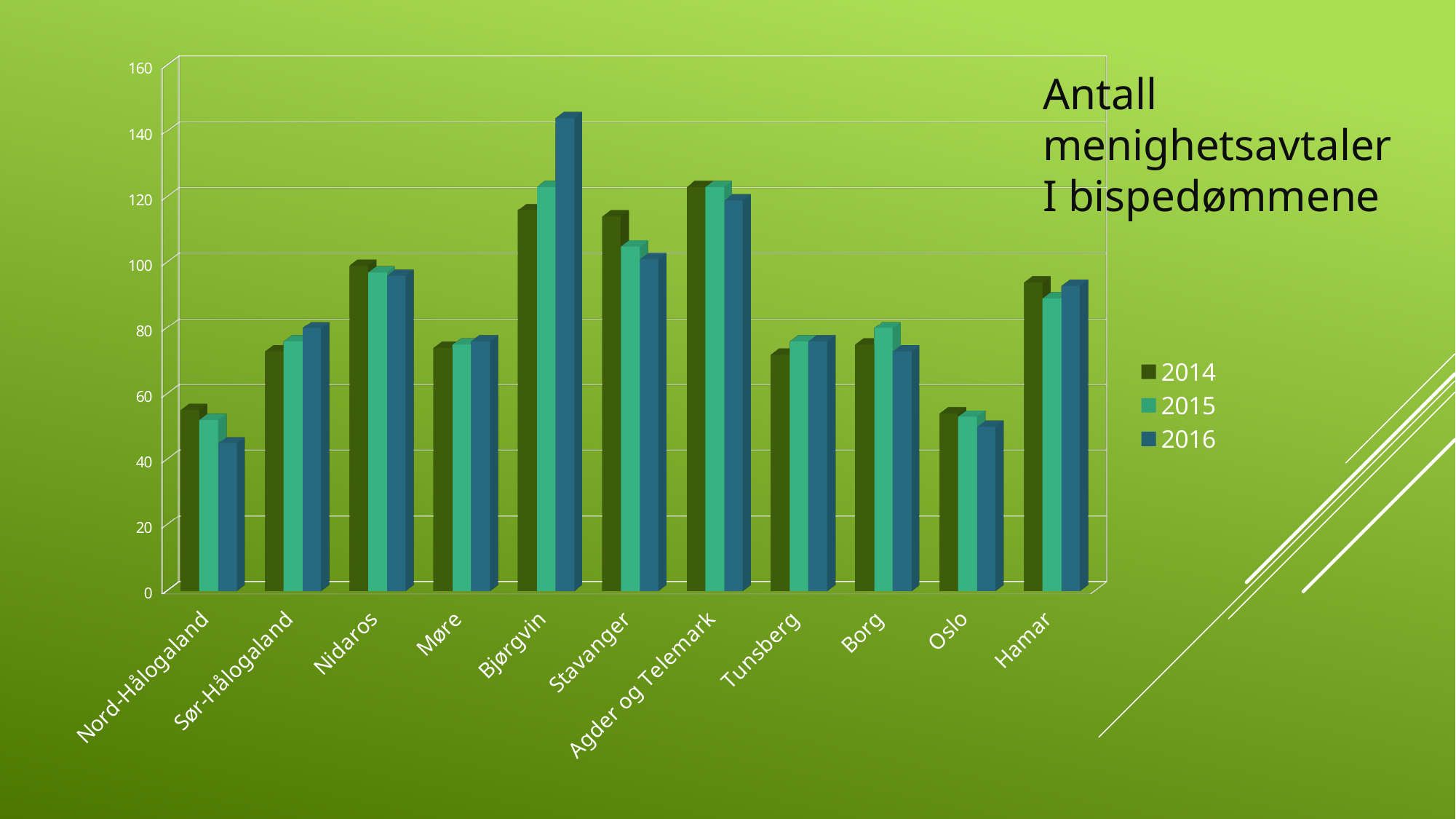
What is the title of the chart? Antall menighetsavtaler I bispedømmene Do the values for Bjørgvin rise or fall from 2014 to 2016? rise Is the 2014 value for Nidaros greater or less than 80? greater Is the 2016 value for Bjørgvin greater or less than 120? greater Is the 2016 value for Oslo greater or less than 60? less What kind of chart is shown on the slide? bar chart Which is larger, the 2016 value for Bjørgvin or the 2016 value for Stavanger? Bjørgvin How many categories (bispedømmer) are shown on the x axis? 11 How many series does the legend list? 3 Do the values for Stavanger rise or fall from 2014 to 2016? fall Which category has the tallest bar in the chart? Bjørgvin Which category has the highest value for the 2014 series? Agder og Telemark